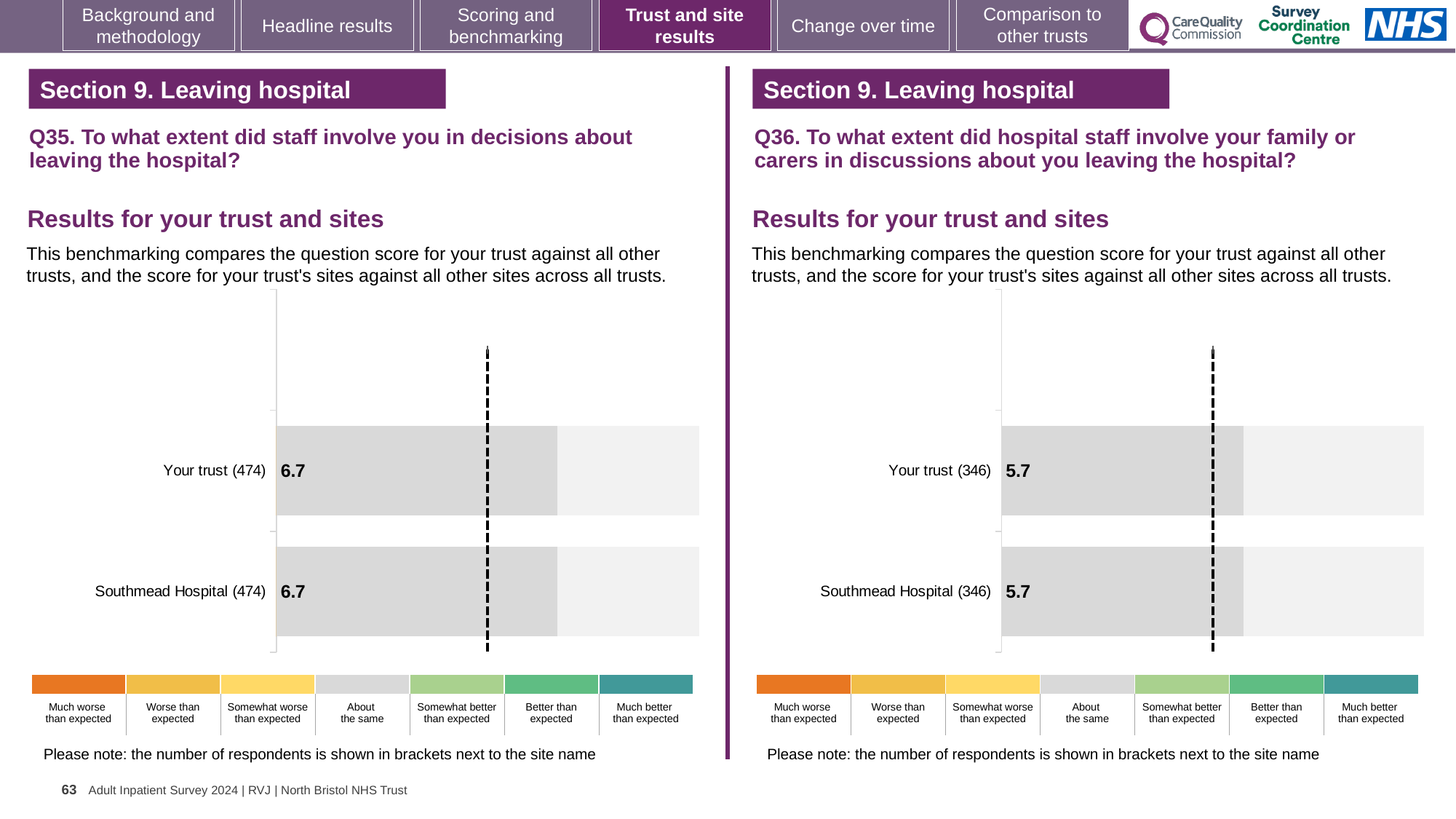
On the Q36 chart (right), how many respondents are shown in brackets next to Southmead Hospital? 346 On the Q36 chart (right), what is the score for Southmead Hospital? 5.7 On the Q35 chart (left), how many respondents are shown in brackets next to Your trust? 474 On the Q35 chart (left), what is the score for Your trust? 6.7 How many bars are plotted on the Q36 chart (right)? 2 How many bars are plotted on the Q35 chart (left)? 2 Is the Your trust score on the Q35 chart (left) larger or smaller than the Your trust score on the Q36 chart (right)? Larger On the Q35 chart (left), what is the difference between the Your trust score and the Southmead Hospital score? 0 On the Q36 chart (right), what is the difference between the Your trust score and the Southmead Hospital score? 0 On the Q36 chart (right), what is the score for Your trust? 5.7 What kind of chart is the Q35 chart (left)? Bar chart On the Q35 chart (left), what is the score for Southmead Hospital? 6.7